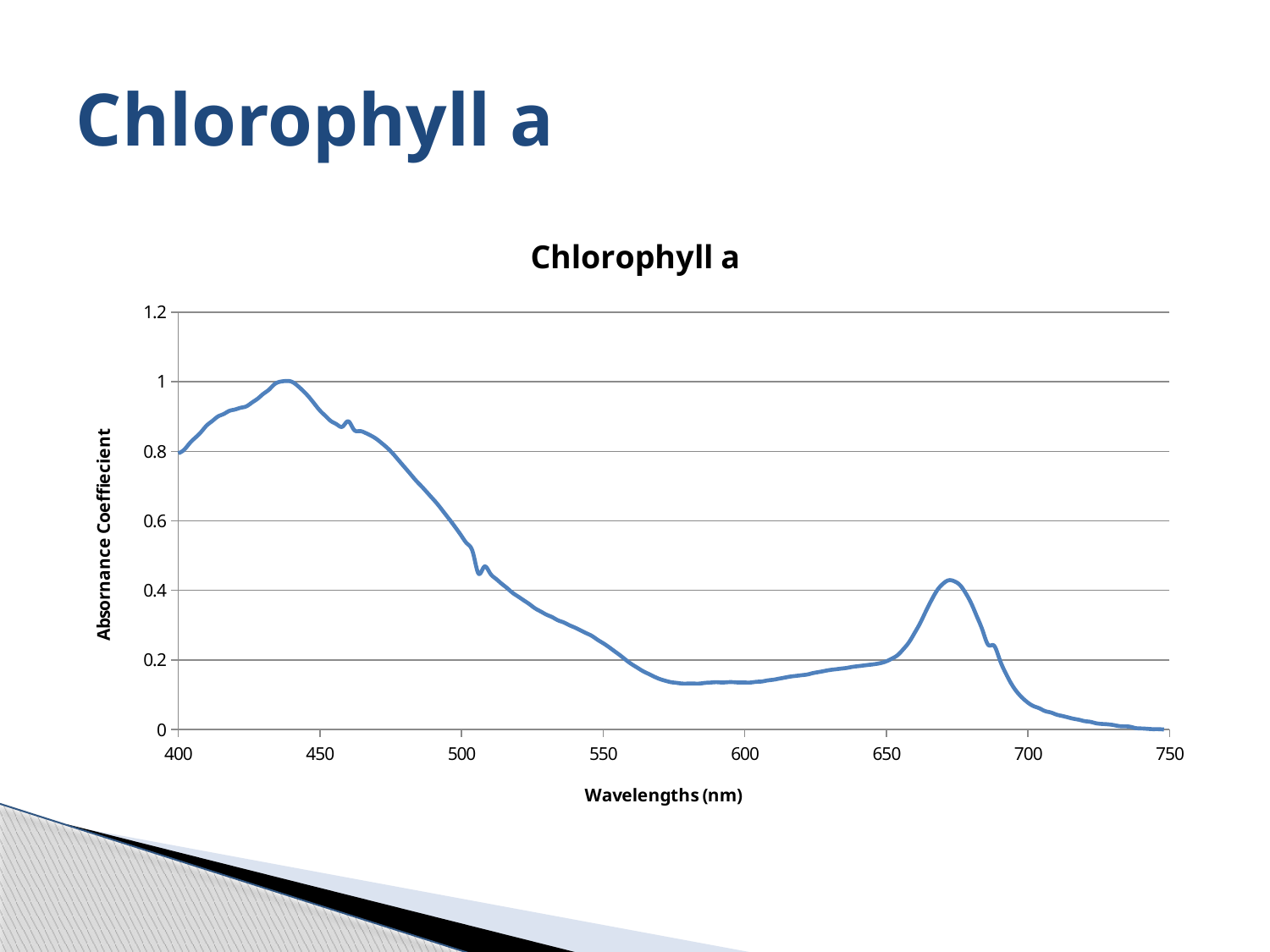
Which is larger, the absorbance coefficient at 400 nm or at 750 nm? 400 nm What kind of chart is shown on the slide? line chart Is the absorbance coefficient at 550 nm greater or less than 0.4? less Does the absorbance coefficient rise or fall as the wavelength increases from 700 nm to 750 nm? fall What is the label of the x axis of the chart? Wavelengths (nm) Is the absorbance coefficient at 500 nm greater or less than 0.4? greater Is the absorbance coefficient at 400 nm greater or less than 0.6? greater Does the absorbance coefficient rise or fall as the wavelength increases from 450 nm to 550 nm? fall What is the title of the chart? Chlorophyll a Which peak is higher, the one near 440 nm or the one near 670 nm? the one near 440 nm